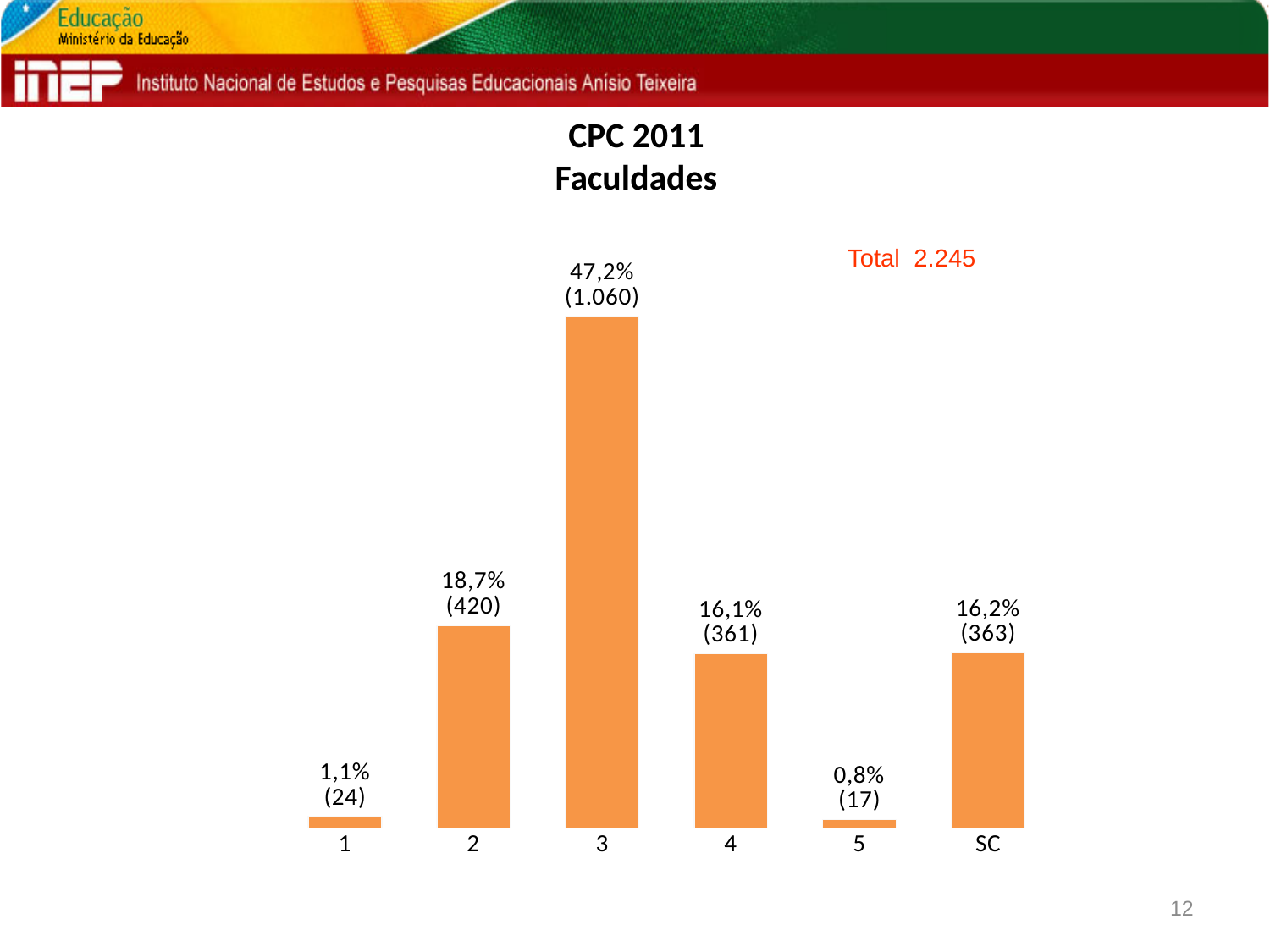
Which category has the highest value? 3 Which category has the lowest value? 5 What total is printed on the slide next to the chart? 2.245 What percentage is shown for category SC? 16,2% What kind of chart is shown? bar chart What percentage is shown for category 3? 47,2% How many categories are shown on the x axis? 6 What count is shown in parentheses for category 2? 420 What is the difference in count between category SC and category 4? 2 What count is shown in parentheses for category 5? 17 What is the difference in count between category 3 and category 2? 640 Which is larger, the value for category 2 or the value for category 4? 2